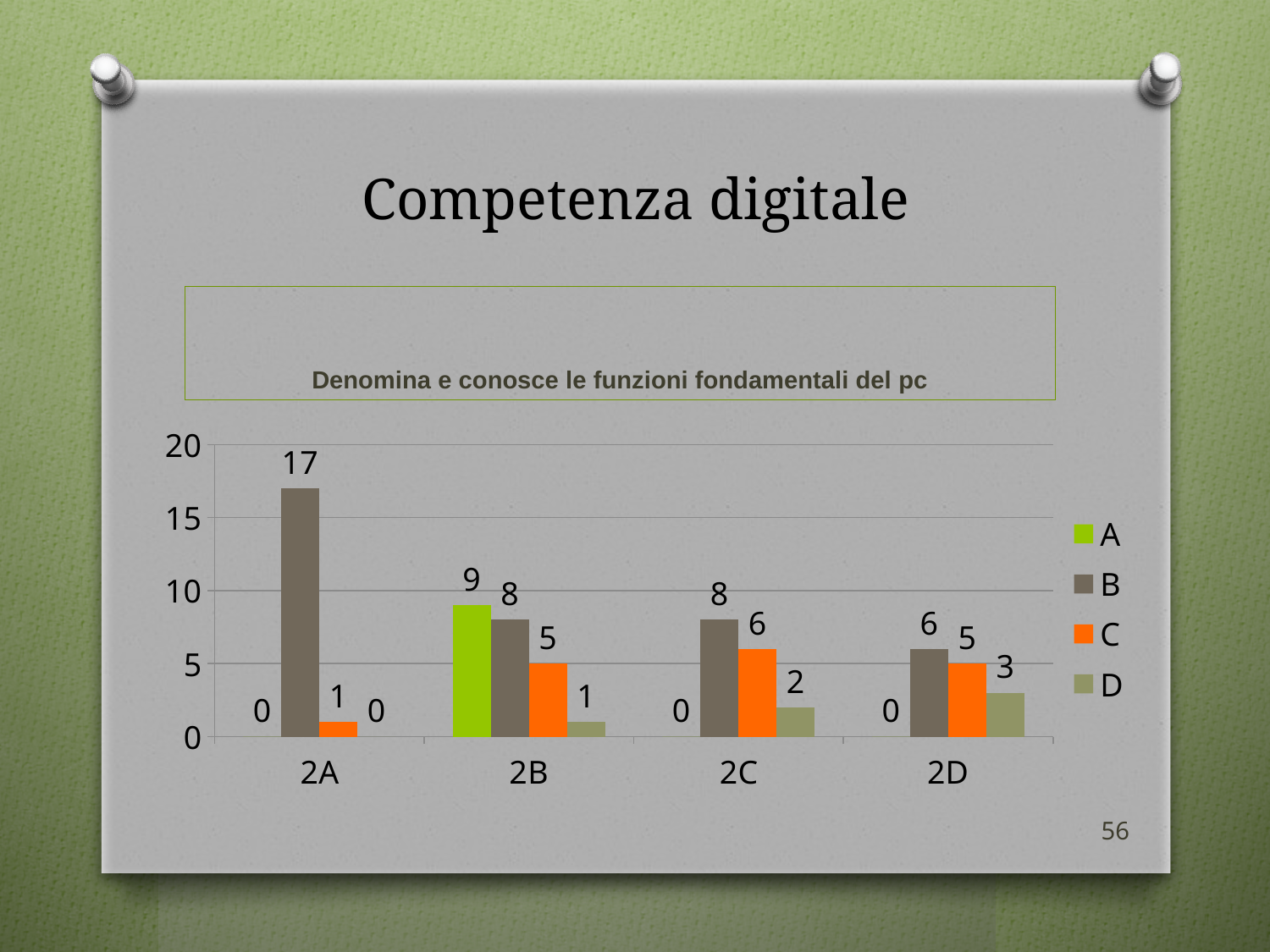
What is the title of the chart? Denomina e conosce le funzioni fondamentali del pc How many series does the legend list? 4 Which category has the lowest value for series C? 2A What is the value of series B for category 2A? 17 What kind of chart is shown on the slide? bar chart Which category has the highest value for series B? 2A What is the value of series D for category 2D? 3 What is the value of series A for category 2B? 9 What is the difference between the value of series B for 2A and the value of series B for 2B? 9 How many categories are shown on the x axis? 4 Which is larger: the value of series C for 2B or the value of series C for 2C? 2C What is the value of series C for category 2C? 6